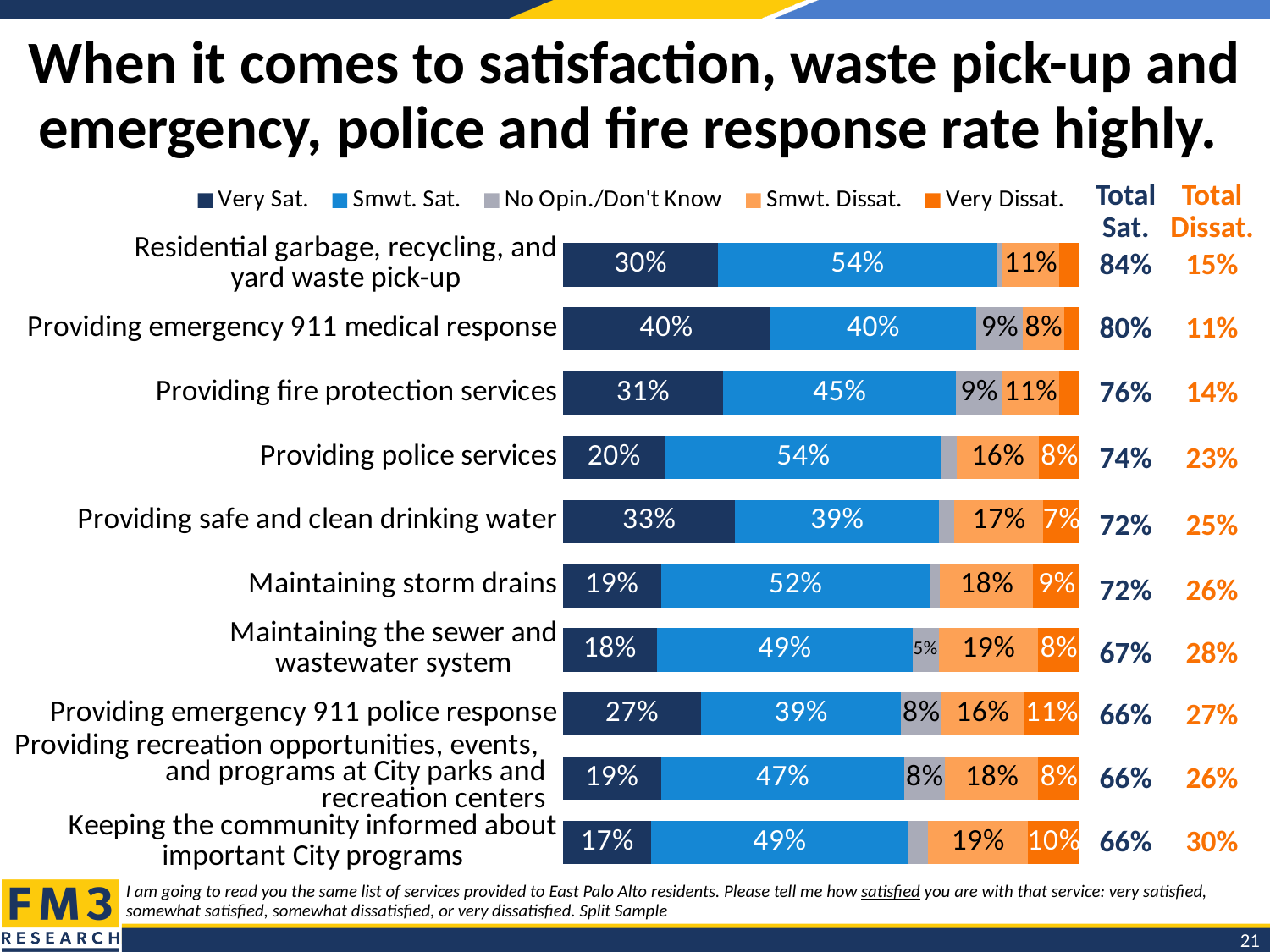
Which has the larger Smwt. Sat. value: "Providing fire protection services" or "Providing recreation opportunities, events, and programs at City parks and recreation centers"? Providing recreation opportunities, events, and programs at City parks and recreation centers How many series does the legend list? 5 What is the Very Sat. value for "Providing emergency 911 medical response"? 40% Which category has the highest Very Sat. value? Providing emergency 911 medical response Which category has the lowest Smwt. Dissat. value? Providing emergency 911 medical response What is the Total Sat. shown for "Residential garbage, recycling, and yard waste pick-up"? 84% What is the Very Dissat. value for "Providing emergency 911 police response"? 11% What is the difference between the Very Sat. values for "Residential garbage, recycling, and yard waste pick-up" and "Providing police services"? 10 percentage points What is the Smwt. Sat. value for "Maintaining storm drains"? 52% What is the Smwt. Dissat. value for "Providing police services"? 16% What kind of chart is shown on the slide? Stacked bar chart How many service categories are plotted in the chart? 10